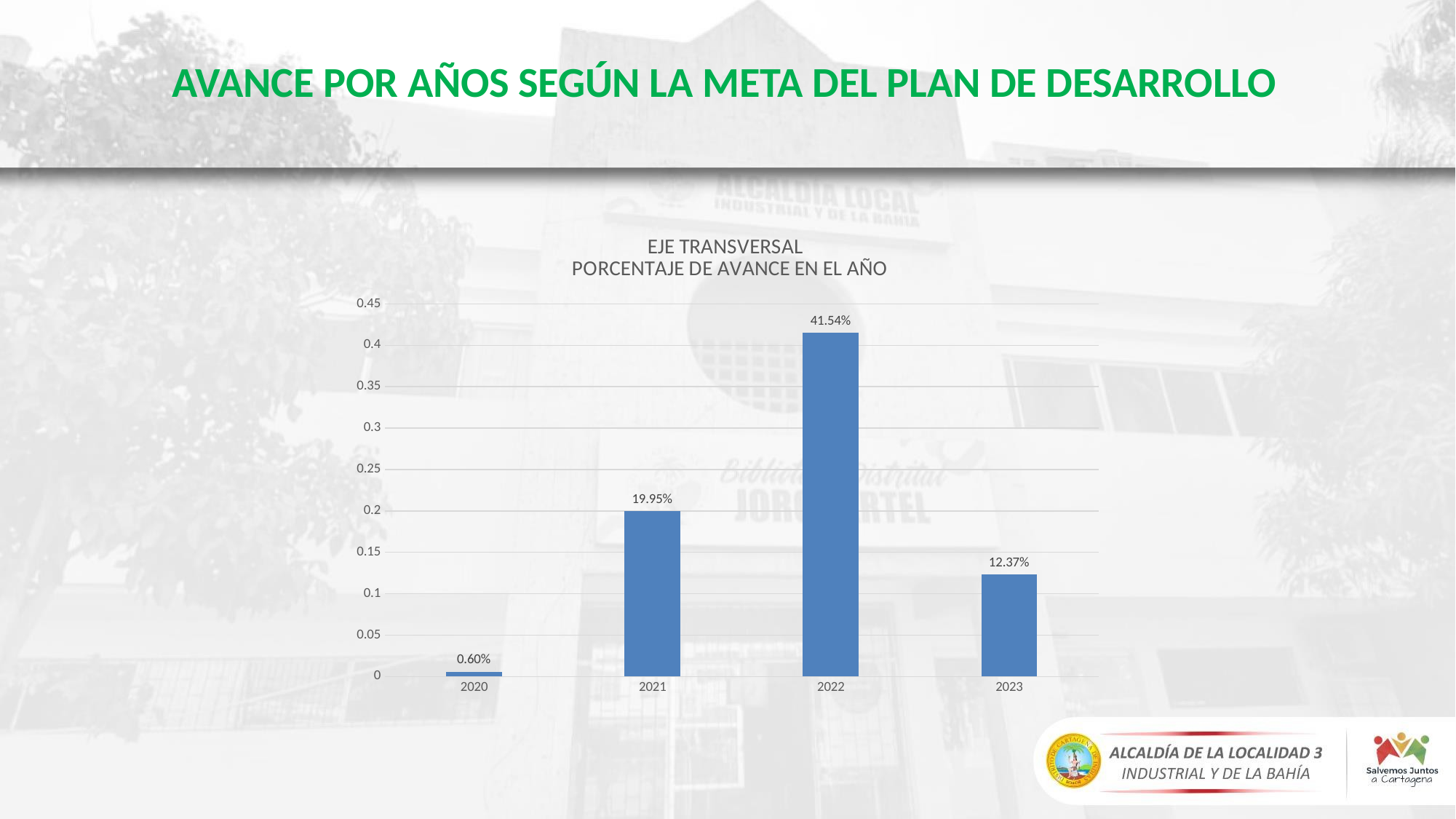
What is the value for 2020? 0.60% Which is larger, the value for 2021 or the value for 2023? 2021 What is the value for 2022? 41.54% How many years are shown on the x axis? 4 What is the title of the chart? EJE TRANSVERSAL PORCENTAJE DE AVANCE EN EL AÑO What is the value for 2023? 12.37% Is the value for 2022 greater or less than 0.4? greater Which year has the lowest value? 2020 Which year has the highest value? 2022 What kind of chart is shown? Bar chart What is the difference between the values for 2022 and 2021? 21.59% What is the value for 2021? 19.95%